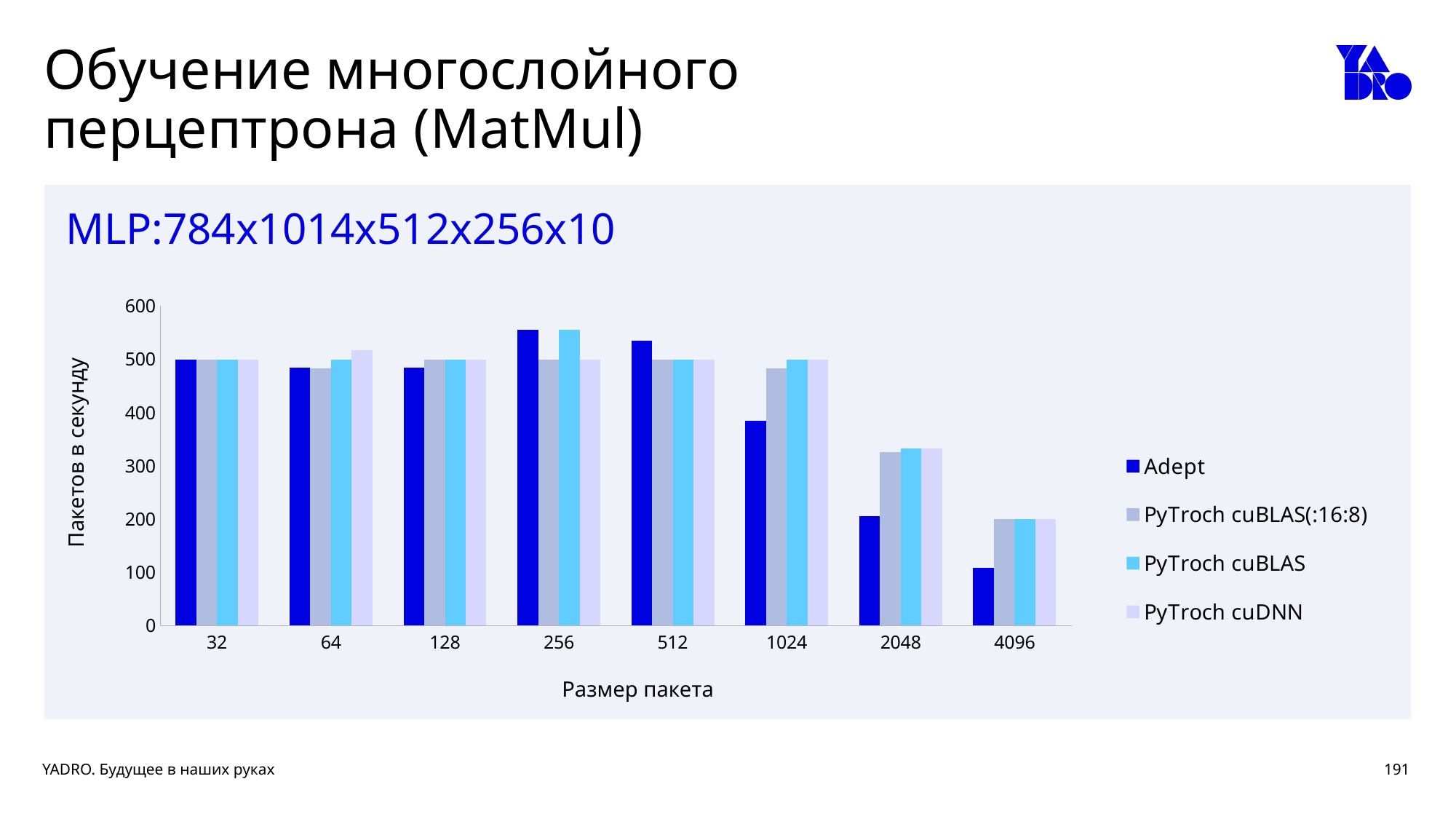
How many batch sizes (categories) are shown on the x axis? 8 What is the title of the x axis? Размер пакета For the Adept series, at which batch size is the value lowest? 4096 What kind of chart is shown on the slide? bar chart For the Adept series, at which batch size is the value highest? 256 Is the value for Adept at batch size 4096 greater or less than 200? less Is the value for Adept at batch size 256 greater or less than 500? greater Do the Adept values rise or fall as the batch size increases from 512 to 4096? fall How many series does the legend list? 4 Is the value for PyTroch cuBLAS at batch size 2048 greater or less than 300? greater At batch size 2048, which is larger: Adept or PyTroch cuDNN? PyTroch cuDNN